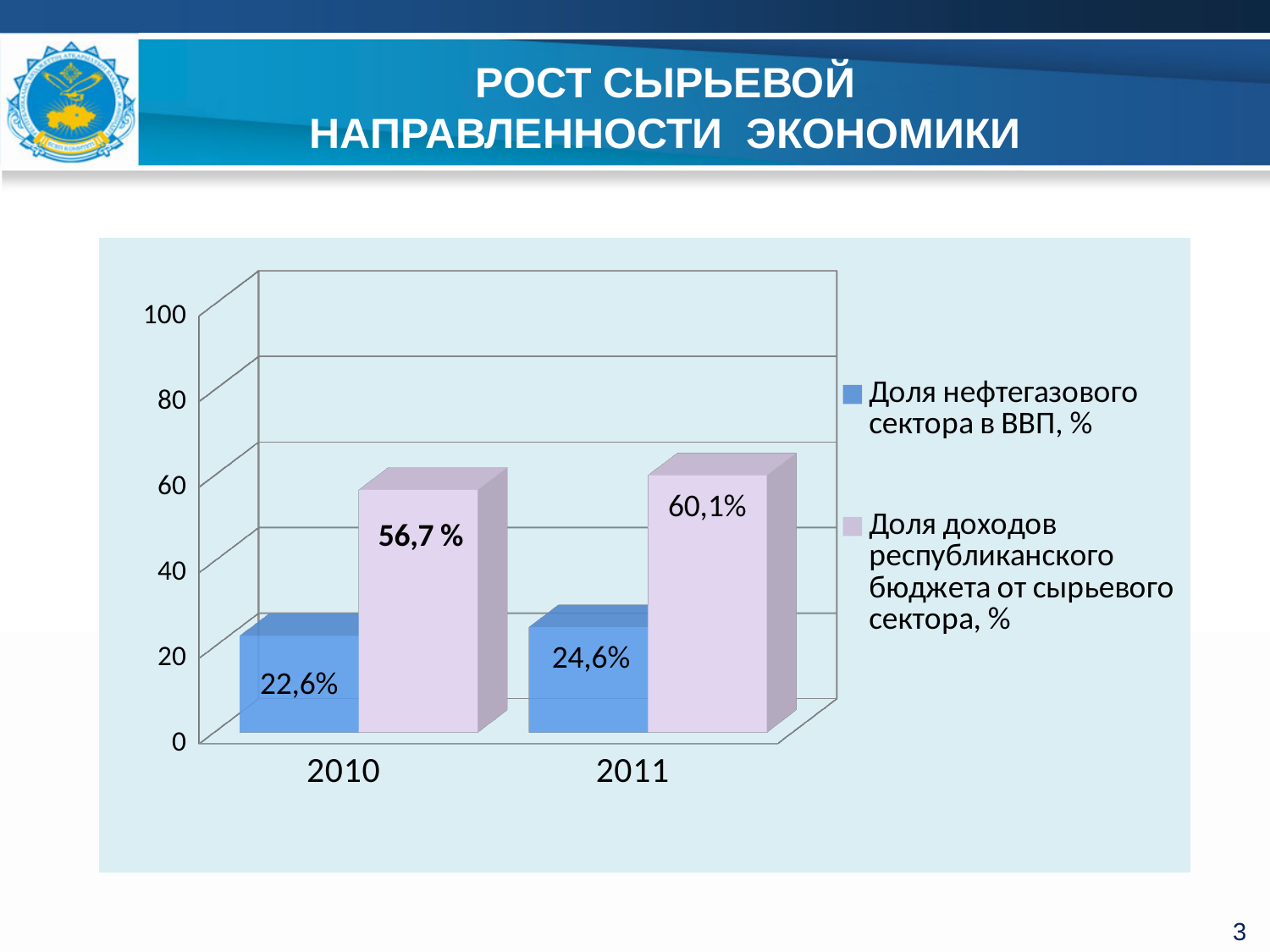
What kind of chart is shown on the slide? Bar chart What is the value of 'Доля нефтегазового сектора в ВВП, %' for 2010? 22,6% How many years are shown on the x axis? 2 What is the value of 'Доля доходов республиканского бюджета от сырьевого сектора, %' for 2011? 60,1% Which year has the lower value for 'Доля нефтегазового сектора в ВВП, %'? 2010 What is the difference between the two series values for 2011? 35,5 What is the value of 'Доля доходов республиканского бюджета от сырьевого сектора, %' for 2010? 56,7 % Which is larger in 2010: 'Доля нефтегазового сектора в ВВП, %' or 'Доля доходов республиканского бюджета от сырьевого сектора, %'? Доля доходов республиканского бюджета от сырьевого сектора, % How many series does the legend list? 2 What is the value of 'Доля нефтегазового сектора в ВВП, %' for 2011? 24,6% By how much did 'Доля нефтегазового сектора в ВВП, %' change from 2010 to 2011? 2,0 Which year has the higher value for 'Доля доходов республиканского бюджета от сырьевого сектора, %'? 2011